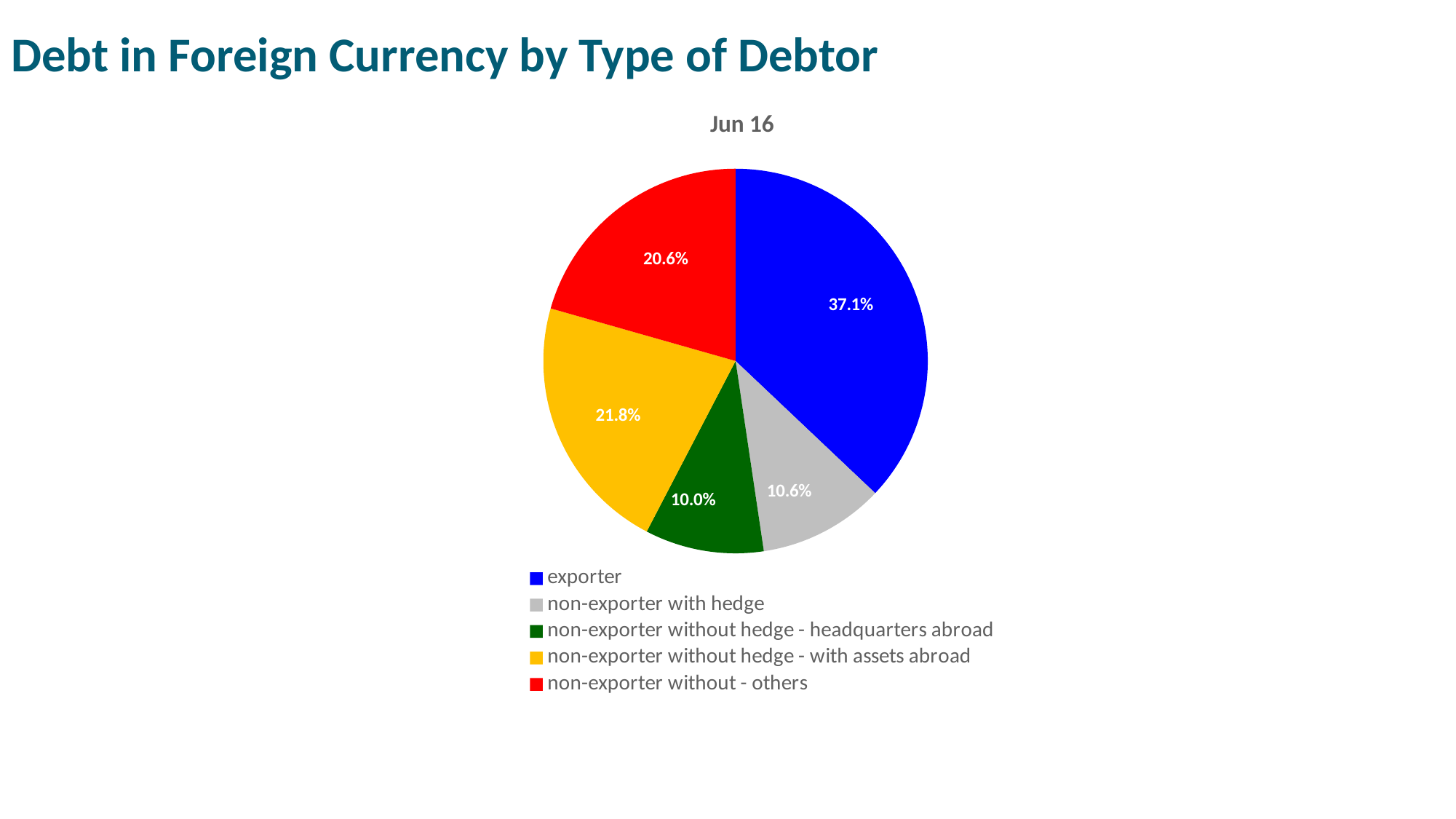
What is the difference between the exporter share and the non-exporter without hedge - with assets abroad share? 15.3% Which category has the largest share of the pie? exporter What is the title shown above the pie chart? Jun 16 What kind of chart is shown on the slide? pie chart How many categories does the pie chart show? 5 What is the value for non-exporter with hedge? 10.6% What is the value for non-exporter without hedge - headquarters abroad? 10.0% What share of the pie does the exporter slice represent? 37.1% What is the value for non-exporter without - others? 20.6% What is the value for non-exporter without hedge - with assets abroad? 21.8% Which category has the smallest share of the pie? non-exporter without hedge - headquarters abroad Which is larger: non-exporter without hedge - with assets abroad or non-exporter without - others? non-exporter without hedge - with assets abroad